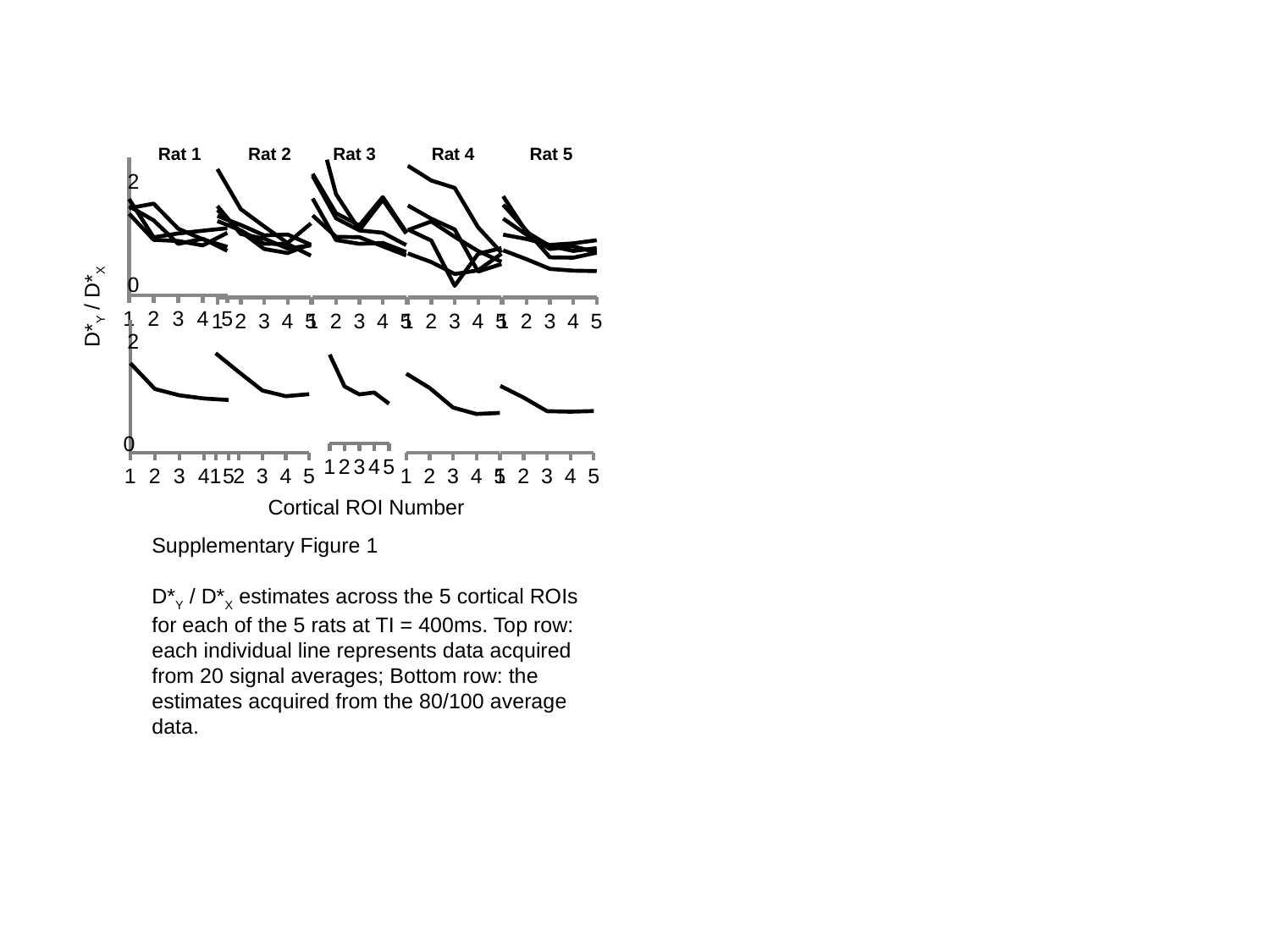
In the bottom-row Rat 1 panel, is the value at ROI 1 larger or smaller than the value at ROI 5? larger What is the label of the y axis? D*Y / D*X In the bottom-row Rat 2 panel, which ROI has the highest value? 1 In the bottom-row Rat 1 panel, which ROI has the highest value? 1 In the bottom-row Rat 4 panel, does the line rise or fall from ROI 1 to ROI 4? fall What is the x-axis title of the figure? Cortical ROI Number In the bottom-row Rat 1 panel, is the value at ROI 1 greater or less than 2? less What kind of chart is used in the panels of this figure? line chart How many cortical ROI numbers are shown on the x axis of each panel? 5 In the bottom-row Rat 1 panel, does the line rise or fall from ROI 1 to ROI 5? fall In the bottom-row Rat 5 panel, is the value at ROI 5 greater or less than 2? less How many rat panels are shown in the top row of the figure? 5